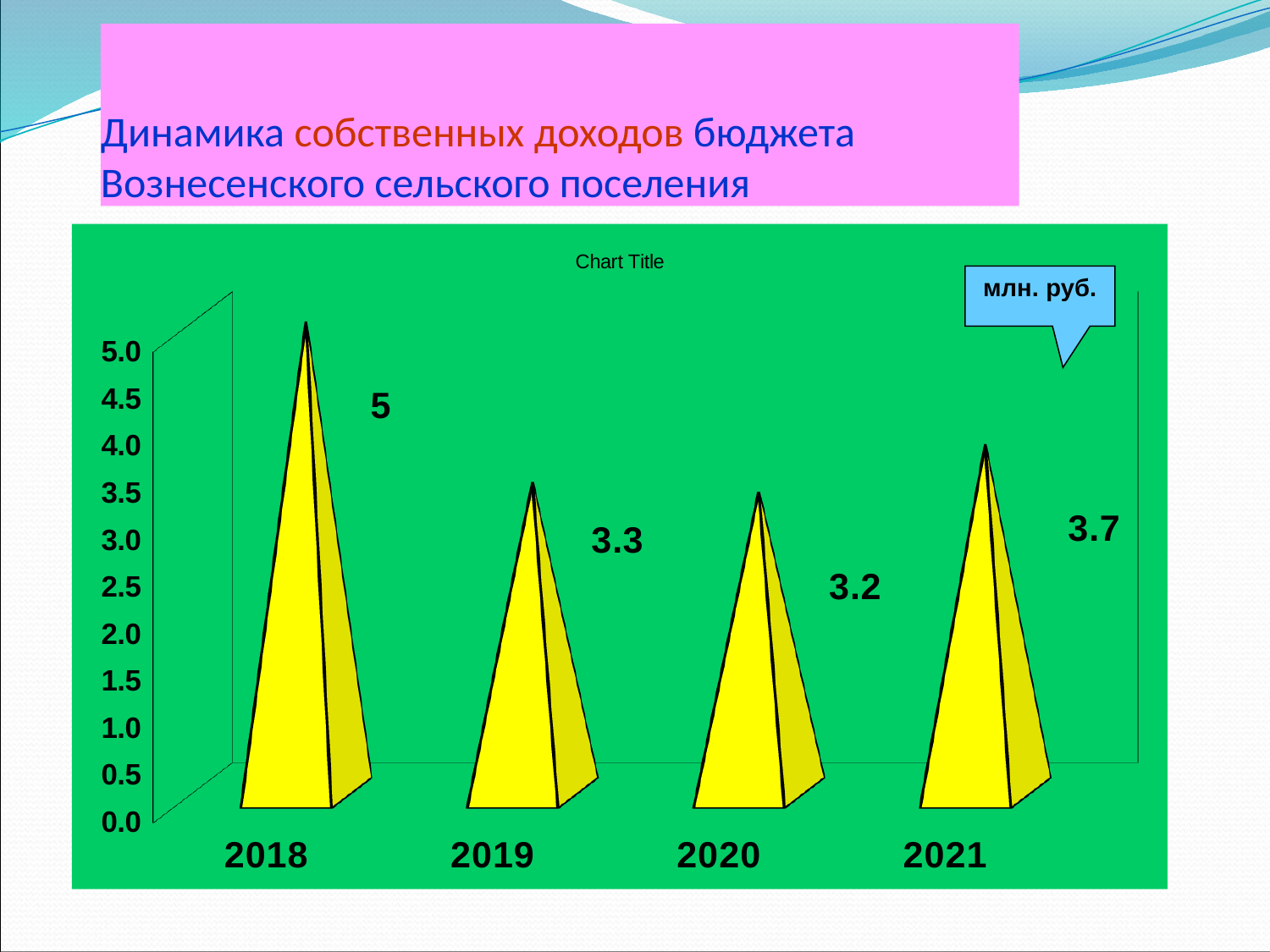
What is the value for 2019? 3.3 What is the value for 2018? 5 Which year has the lowest value? 2020 What is the value for 2020? 3.2 What is the difference between the values for 2018 and 2021? 1.3 How many years are shown on the x axis? 4 What unit is shown in the callout box on the chart? млн. руб. What is the value for 2021? 3.7 What kind of chart is shown on the slide? bar chart Which is larger, the value for 2019 or the value for 2021? 2021 Which year has the highest value? 2018 Is the value for 2018 greater or less than 4.0? greater